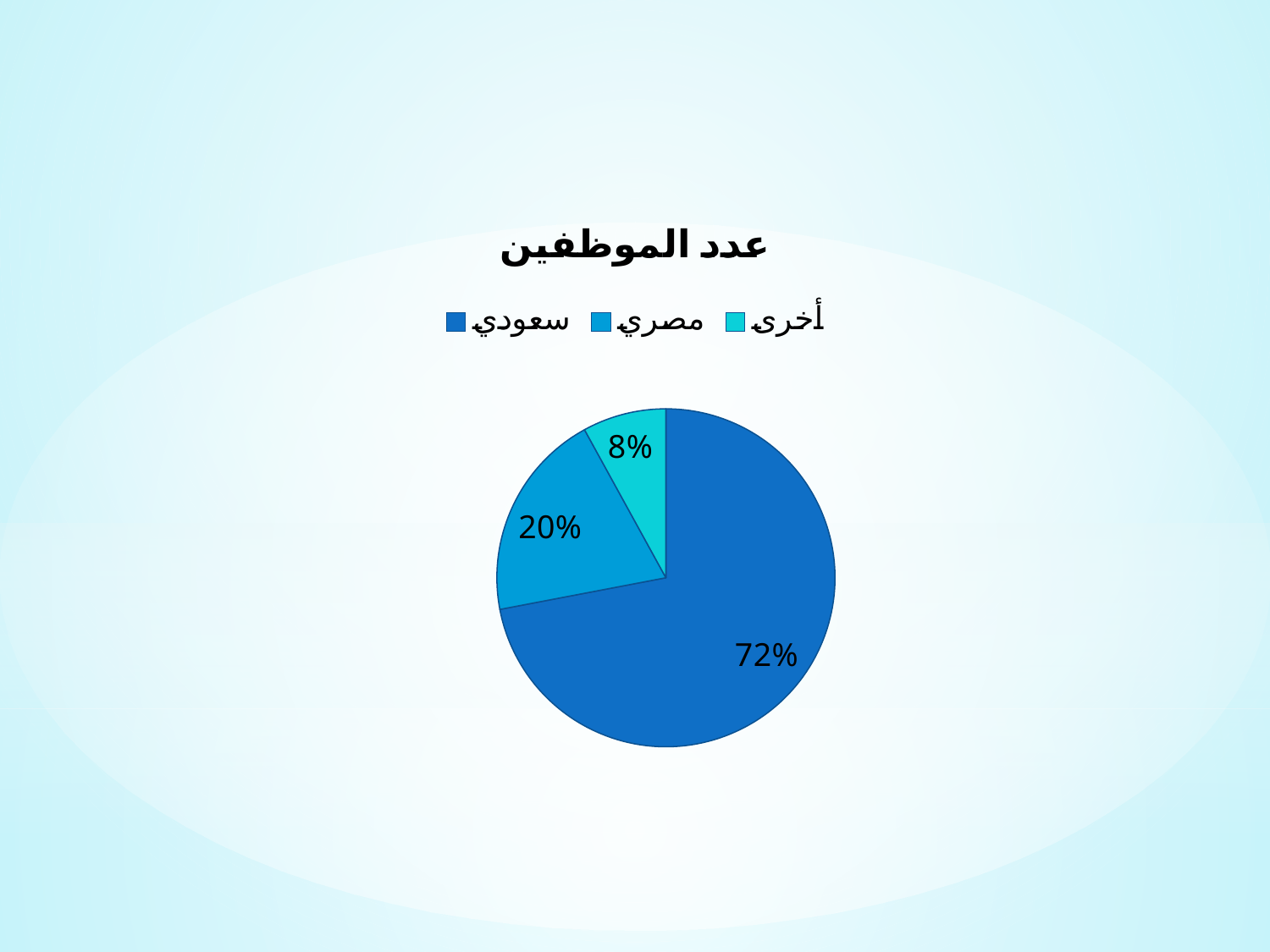
How many categories does the legend list? 3 Which legend entry is shown in the lightest (cyan) colour? أخرى What is the title of the chart? عدد الموظفين Which category has the smallest slice of the pie? أخرى What is the combined share of the مصري and أخرى slices? 28% What share of the pie does أخرى represent? 8% What is the difference in percentage points between the سعودي slice and the مصري slice? 52 What type of chart is shown on the slide? pie chart Which category has the largest slice of the pie? سعودي What share of the pie does مصري represent? 20% What share of the pie does سعودي represent? 72% Which is larger, the مصري slice or the أخرى slice? مصري